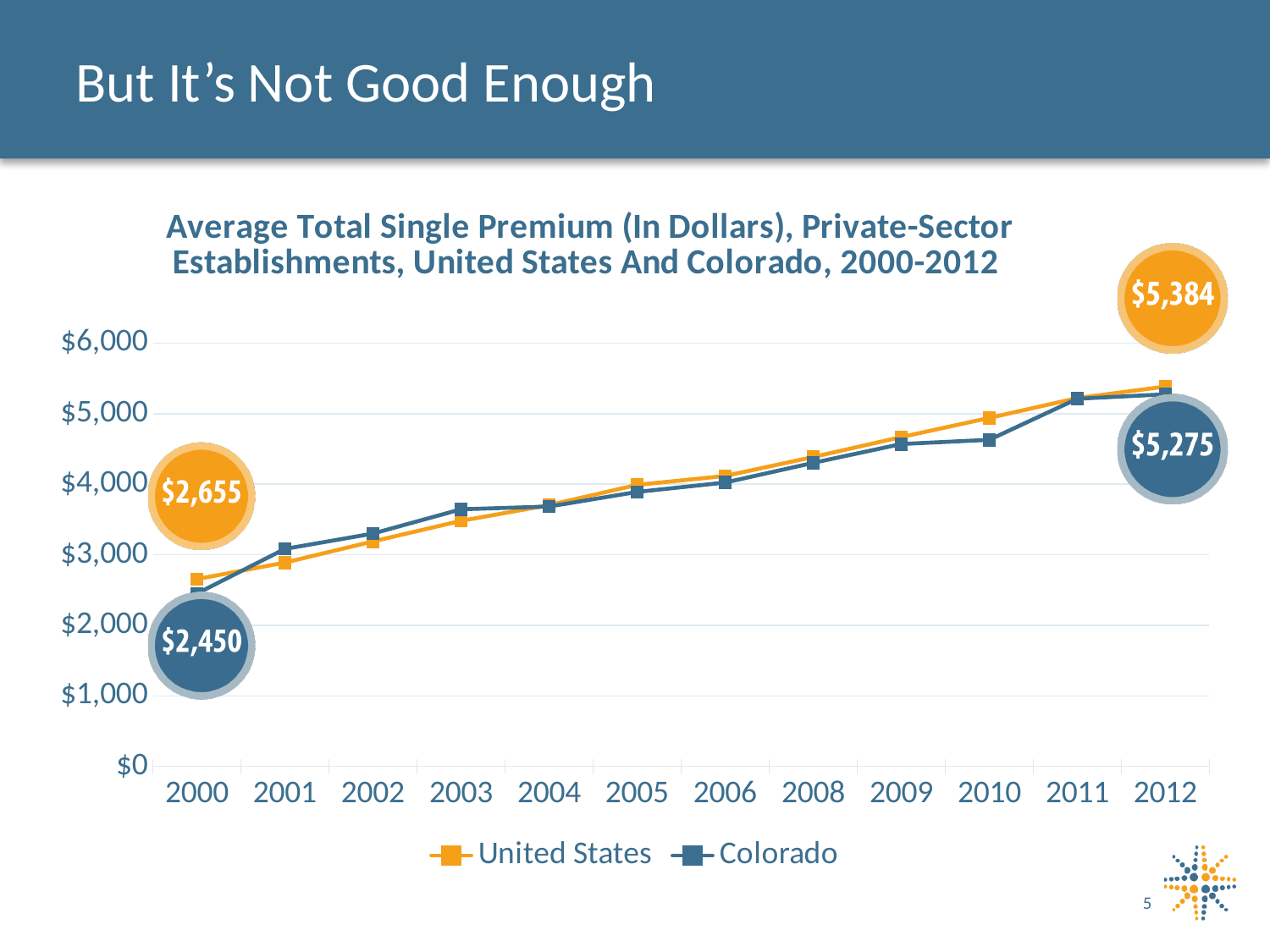
What is the difference between the United States and Colorado average total single premium in 2012? $109 In 2000, which had the higher average total single premium, the United States or Colorado? United States Is the value for Colorado in 2010 greater or less than $5,000? less What was the average total single premium for the United States in 2012? $5,384 What was the average total single premium for the United States in 2000? $2,655 By how much did the United States average total single premium increase from 2000 to 2012? $2,729 By how much did the Colorado average total single premium increase from 2000 to 2012? $2,825 How many series does the legend list? 2 How many years are shown on the x axis? 12 What was the average total single premium for Colorado in 2012? $5,275 What kind of chart is shown on the slide? line chart What was the average total single premium for Colorado in 2000? $2,450